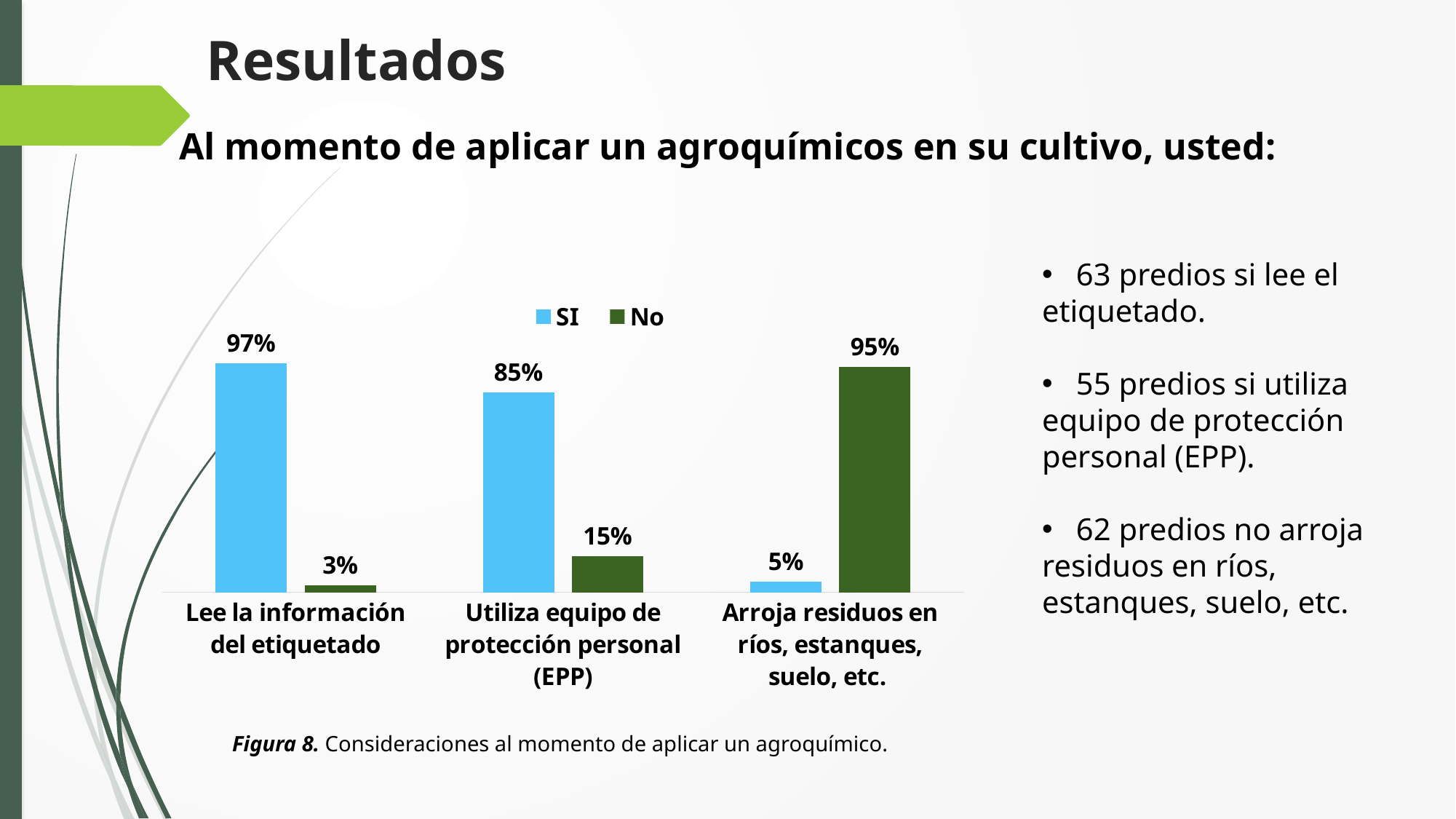
What is the No value for "Utiliza equipo de protección personal (EPP)"? 15% What kind of chart is shown on the slide? Bar chart What is the SI value for "Lee la información del etiquetado"? 97% Which category has the lowest No value? Lee la información del etiquetado What is the difference between the SI and No values for "Utiliza equipo de protección personal (EPP)"? 70% What is the SI value for "Arroja residuos en ríos, estanques, suelo, etc."? 5% For "Arroja residuos en ríos, estanques, suelo, etc.", which is larger, SI or No? No What colour represents the "No" series in the chart? Dark green How many series does the legend list? 2 What is the No value for "Lee la información del etiquetado"? 3% Which category has the highest SI value? Lee la información del etiquetado How many categories are shown on the x axis of the chart? 3